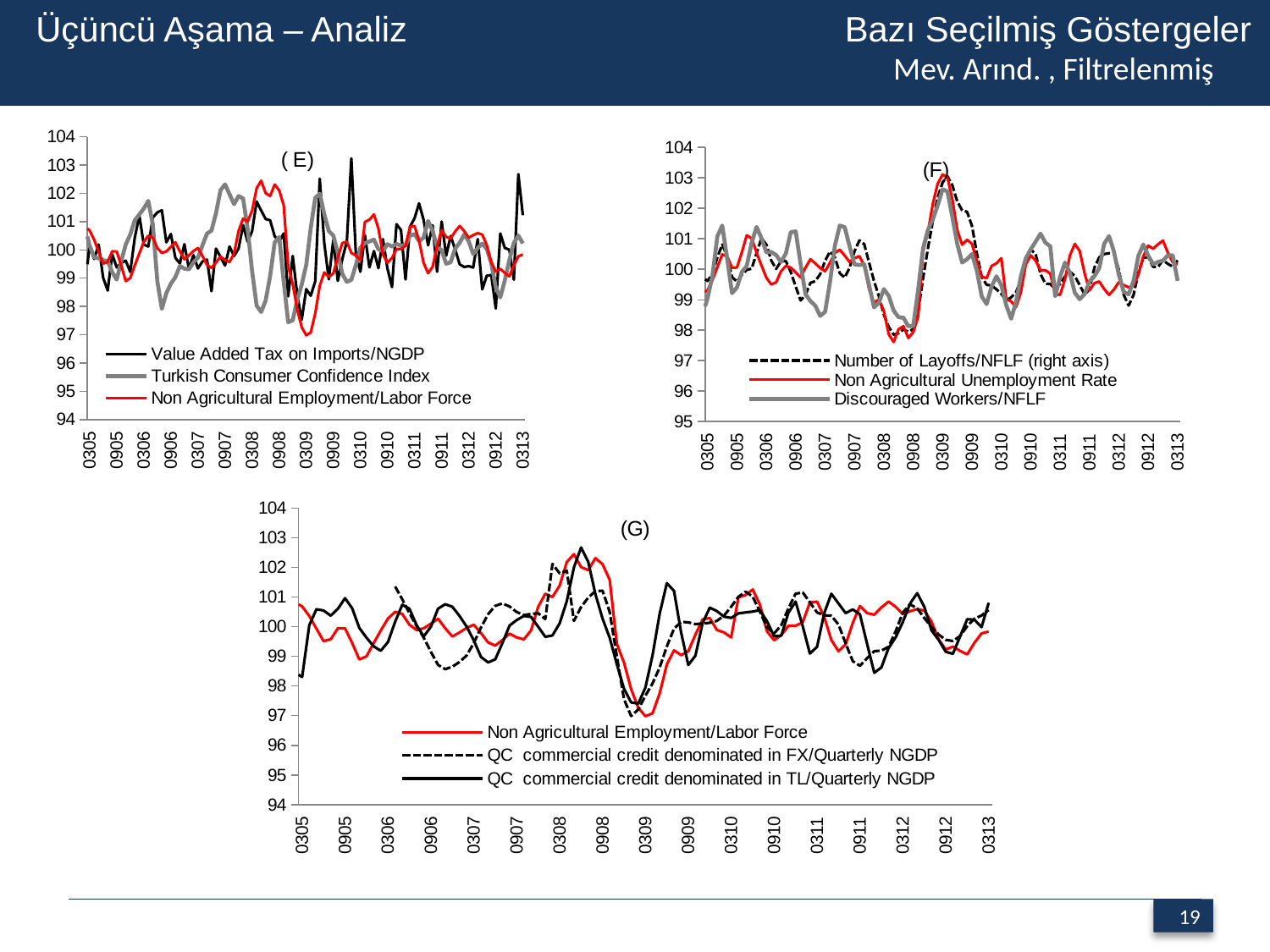
How many series does the legend of chart (G) list? 3 What is the first x-axis label shown on chart (G)? 0305 In chart (F), which series is plotted on the right axis according to the legend? Number of Layoffs/NFLF In chart (E), is the lowest value of Non Agricultural Employment/Labor Force around 0309 greater or less than 98? less What kind of chart is chart (G)? line chart What kind of chart is chart (E)? line chart In chart (F), is the lowest value of Discouraged Workers/NFLF around 0308 greater or less than 99? less In chart (E), which series is drawn in red according to the legend? Non Agricultural Employment/Labor Force In chart (E), is the highest value of Value Added Tax on Imports/NGDP around 0310 greater or less than 102? greater How many series does the legend of chart (F) list? 3